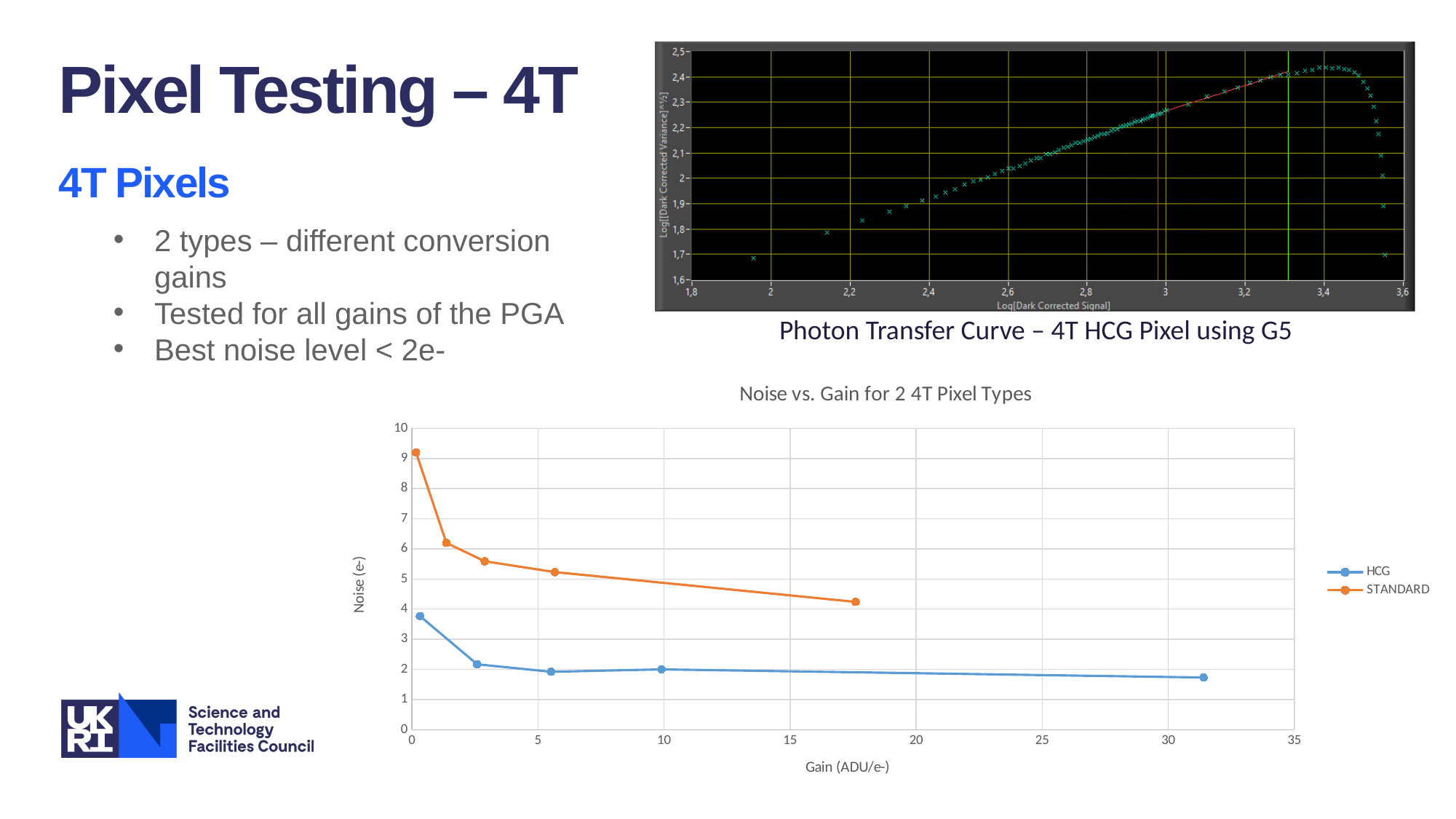
What kind of chart is the 'Photon Transfer Curve – 4T HCG Pixel using G5' chart at the top right? scatter chart In the 'Noise vs. Gain for 2 4T Pixel Types' chart, how many data points are plotted for the HCG series? 5 How many series does the legend of the 'Noise vs. Gain for 2 4T Pixel Types' chart list? 2 In the 'Noise vs. Gain for 2 4T Pixel Types' chart, is the noise of the first STANDARD point (at the lowest gain) greater or less than 8? greater What kind of chart is the 'Noise vs. Gain for 2 4T Pixel Types' chart? line chart In the 'Noise vs. Gain for 2 4T Pixel Types' chart, which series has the higher noise at the lowest gain, HCG or STANDARD? STANDARD In the 'Noise vs. Gain for 2 4T Pixel Types' chart, does the noise of the STANDARD series rise or fall as gain increases? fall In the 'Noise vs. Gain for 2 4T Pixel Types' chart, is the noise of the first HCG point (at the lowest gain) greater or less than 4? less In the 'Noise vs. Gain for 2 4T Pixel Types' chart, how many data points are plotted for the STANDARD series? 5 In the 'Noise vs. Gain for 2 4T Pixel Types' chart, is the noise of the HCG point at the highest gain (around 31) greater or less than 2? less In the 'Noise vs. Gain for 2 4T Pixel Types' chart, what are the two series named in the legend? HCG and STANDARD What is the label of the y axis of the 'Noise vs. Gain for 2 4T Pixel Types' chart? Noise (e-)